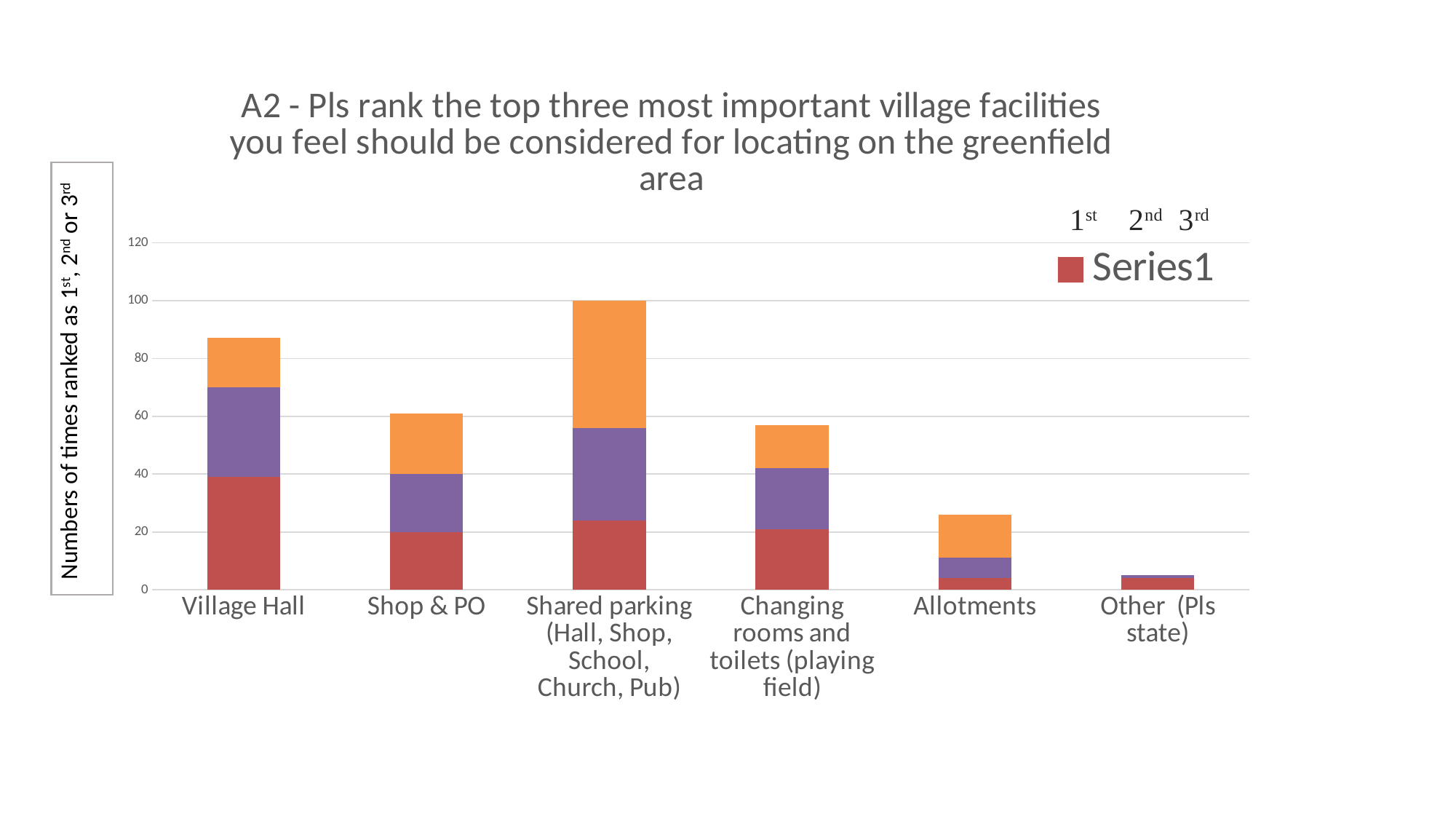
Which category has the tallest stacked bar? Shared parking (Hall, Shop, School, Church, Pub) Is the total for Village Hall greater or less than 80? greater What kind of chart is shown on the slide? stacked bar chart Which category has the shortest stacked bar? Other (Pls state) Which has the taller stacked bar, Village Hall or Shop & PO? Village Hall How many categories are shown on the x axis? 6 Is the total for Shop & PO greater or less than 80? less What is the label of the y axis? Numbers of times ranked as 1st, 2nd or 3rd Is the total for Other (Pls state) greater or less than 20? less How many series does the legend list? 1 Which has the taller stacked bar, Changing rooms and toilets (playing field) or Allotments? Changing rooms and toilets (playing field)